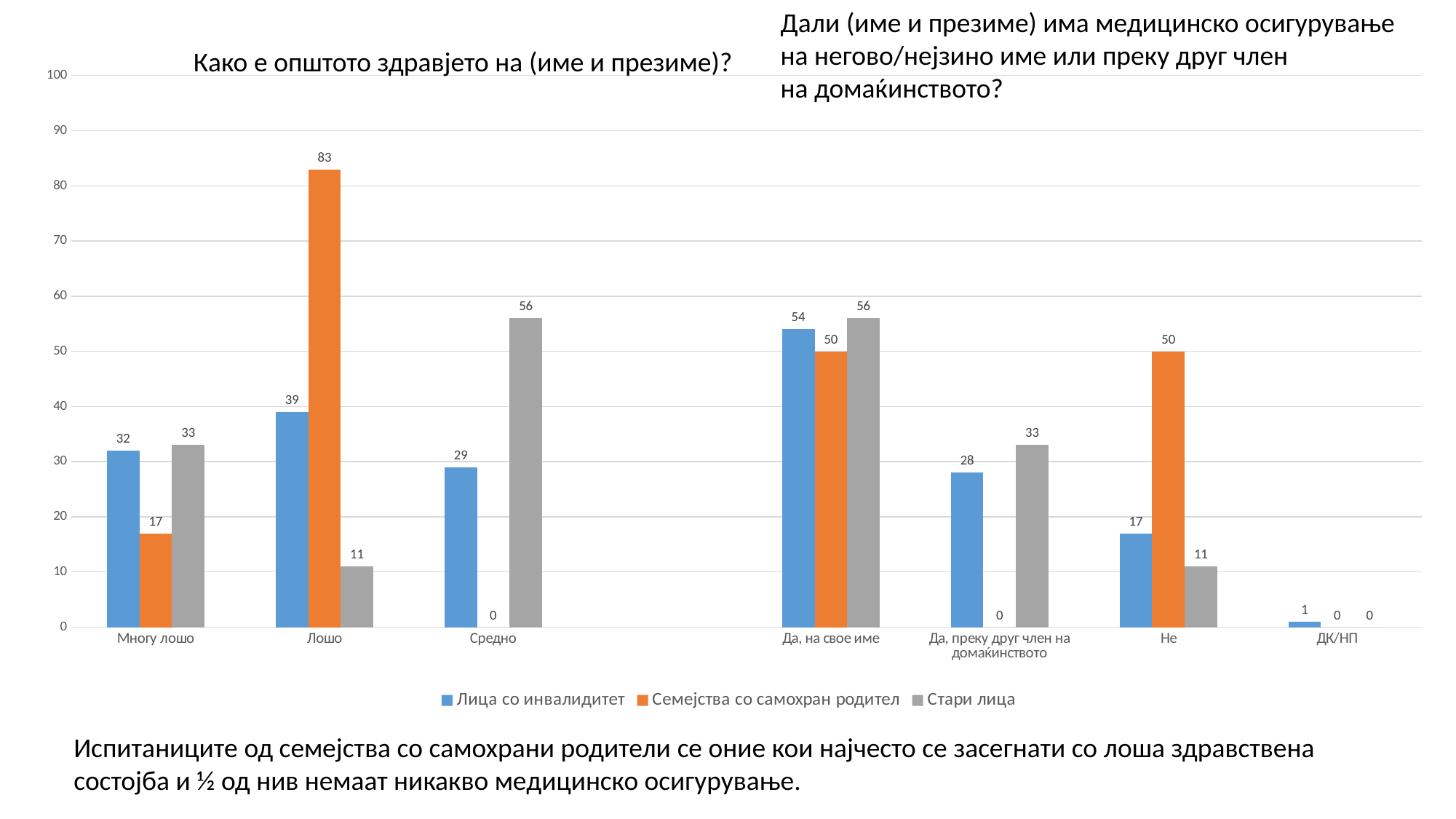
What is the value for Семејства со самохран родител in the Не category? 50 What is the value for Семејства со самохран родител in the Лошо category? 83 What is the value for Стари лица in the Средно category? 56 Which category has the lowest value for Лица со инвалидитет? ДК/НП In the Многу лошо category, which is larger: Лица со инвалидитет or Семејства со самохран родител? Лица со инвалидитет What is the difference between the Семејства со самохран родител and Стари лица values in the Лошо category? 72 How many categories are shown on the x axis? 7 How many series does the legend list? 3 Which category has the highest value for Семејства со самохран родител? Лошо Which series is shown in orange in the legend? Семејства со самохран родител What is the value for Лица со инвалидитет in the Да, на свое име category? 54 What kind of chart is shown on the slide? Bar chart